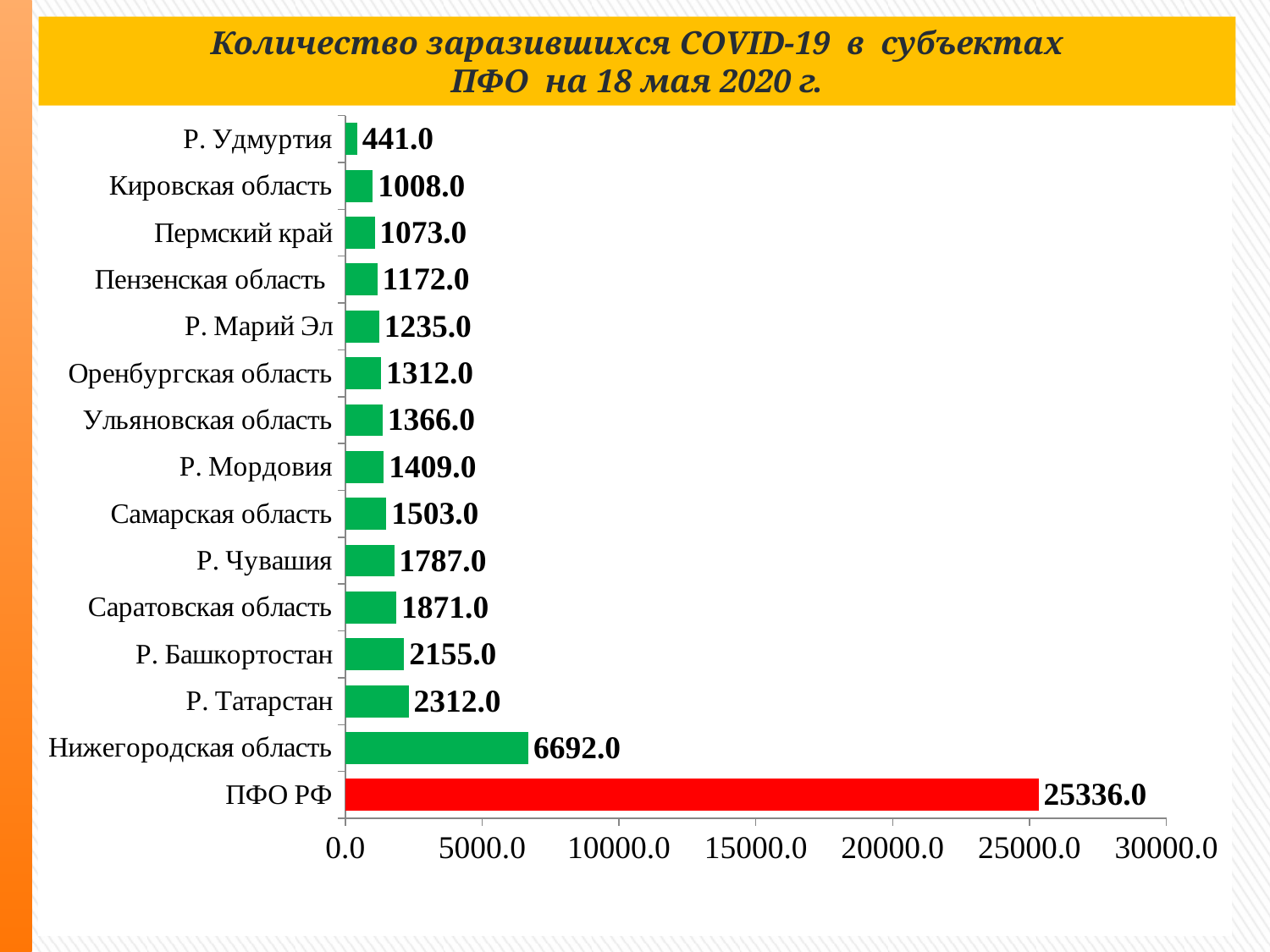
How many categories are shown on the chart? 15 What kind of chart is shown on the slide? bar chart What is the value for Р. Татарстан? 2312.0 What is the difference between the values for Нижегородская область and Р. Татарстан? 4380.0 What is the difference between the values for Р. Башкортостан and Р. Татарстан? 157.0 Which is larger, the value for Саратовская область or the value for Р. Чувашия? Саратовская область Is the value for ПФО РФ greater or less than 25000.0? greater Which category has the lowest value? Р. Удмуртия What is the value for Нижегородская область? 6692.0 Which bar is coloured red rather than green? ПФО РФ What is the value for Р. Удмуртия? 441.0 Which category has the highest value? ПФО РФ